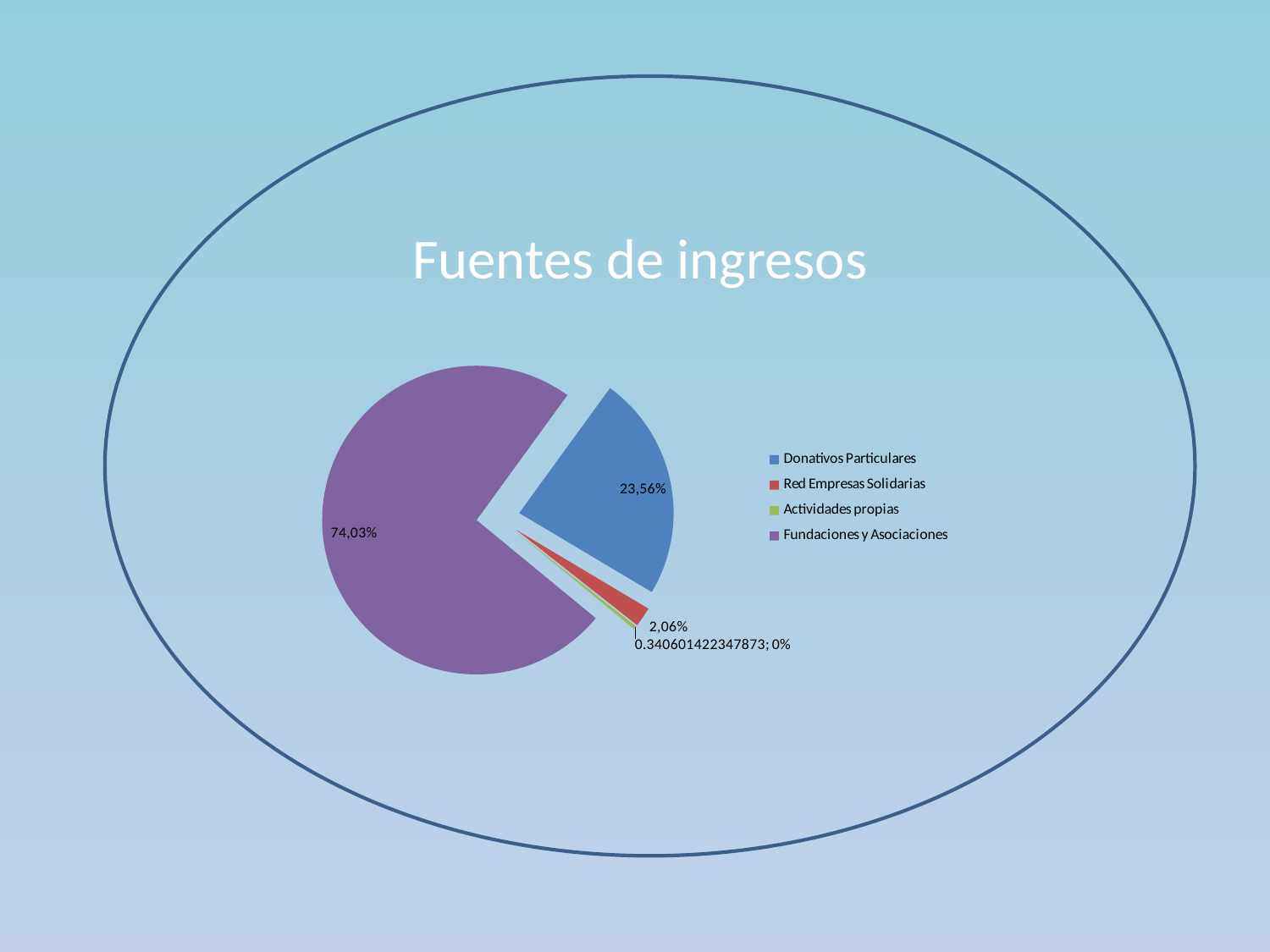
What share of the pie does Donativos Particulares have? 23,56% What is the difference between the shares of Donativos Particulares and Red Empresas Solidarias? 21,50% Which is larger, the share for Donativos Particulares or the share for Red Empresas Solidarias? Donativos Particulares What colour is the slice for Fundaciones y Asociaciones? purple What type of chart is shown on the slide? pie chart What share of the pie does Red Empresas Solidarias have? 2,06% What is the difference between the shares of Fundaciones y Asociaciones and Donativos Particulares? 50,47% How many categories does the legend list? 4 What share of the pie does Fundaciones y Asociaciones have? 74,03% Which category has the smallest slice of the pie? Actividades propias Which category has the largest slice of the pie? Fundaciones y Asociaciones What is the title of the chart? Fuentes de ingresos